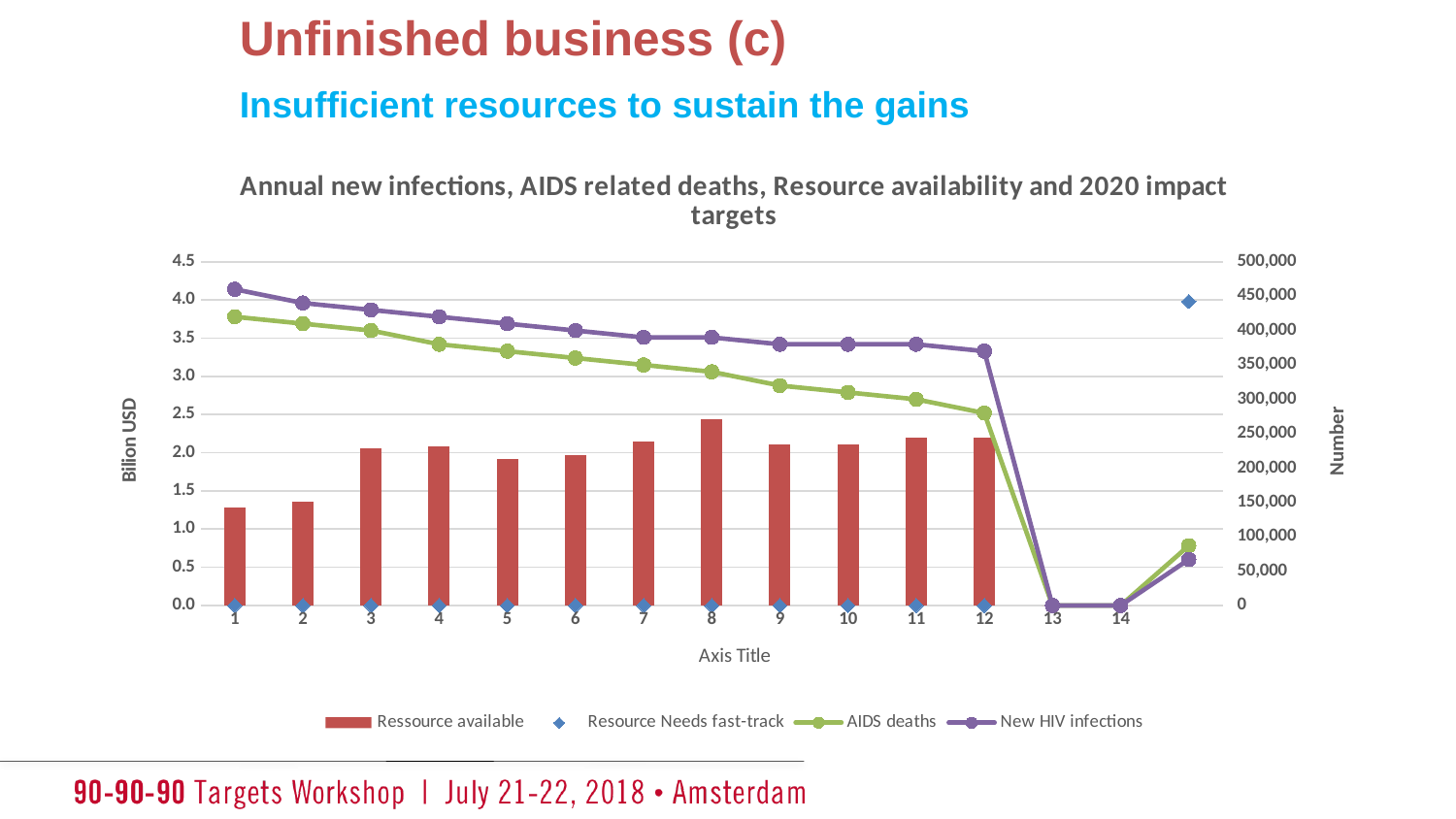
Which is larger at category 1: New HIV infections or AIDS deaths? New HIV infections At which x-axis category is the Ressource available bar highest? 8 Is the Ressource available value at category 8 greater or less than 2.0? greater Which series is plotted as bars? Ressource available Is the AIDS deaths value at category 12 greater or less than 300,000? less What is the title of the chart? Annual new infections, AIDS related deaths, Resource availability and 2020 impact targets Do New HIV infections rise or fall from category 1 to category 12? fall How many series does the legend list? 4 Is the New HIV infections value at category 1 greater or less than 400,000? greater Which is larger for Ressource available: category 8 or category 1? category 8 How many numbered categories are labelled on the x axis? 14